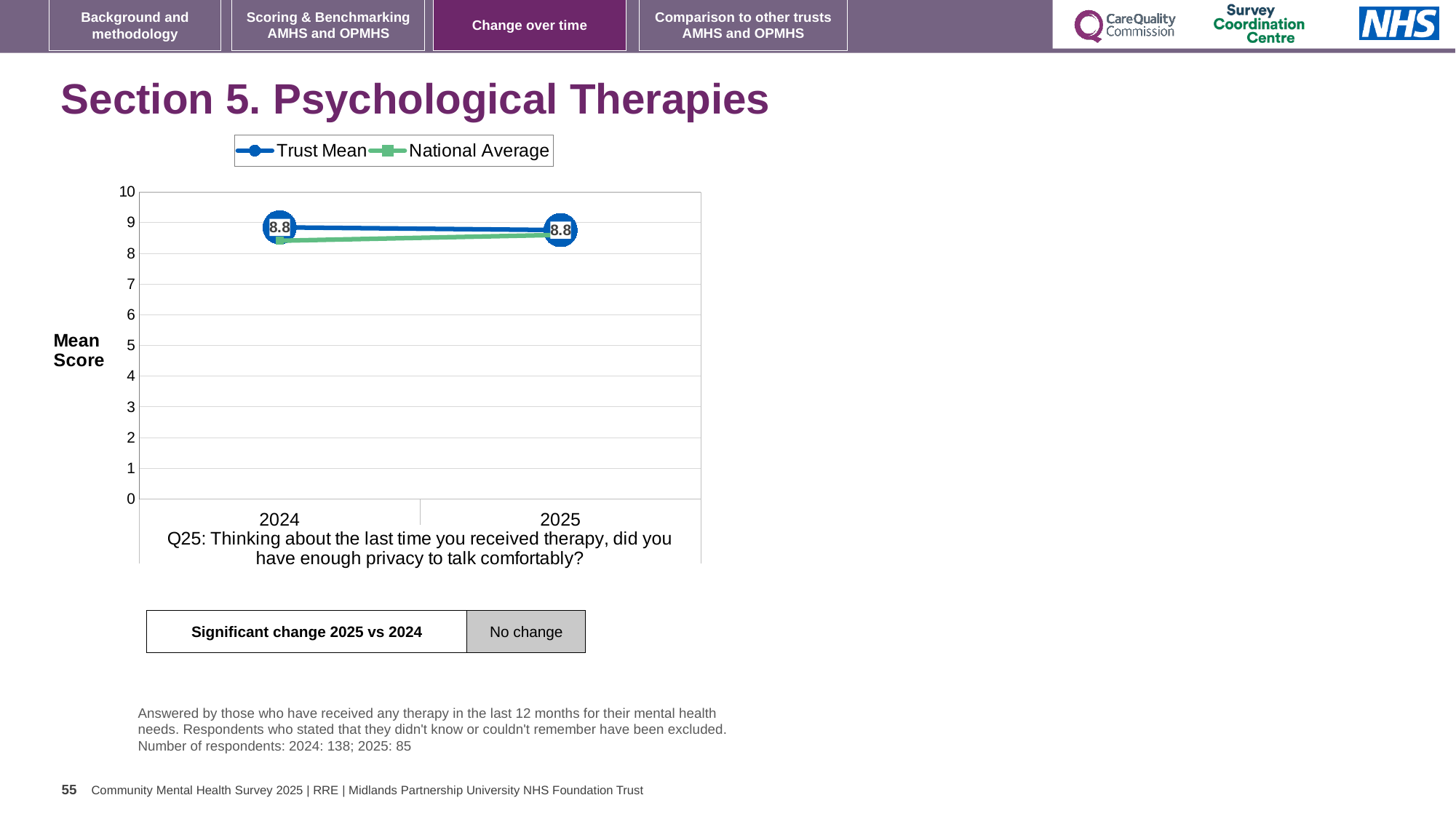
Is the National Average value for 2024 greater or less than 8? greater What is the label on the y axis of the chart? Mean Score What is the Trust Mean value for 2025? 8.8 How many series does the legend list? 2 Does the National Average rise or fall from 2024 to 2025? rises Is the National Average value for 2024 greater or less than 9? less What is the difference between the Trust Mean in 2025 and the Trust Mean in 2024? 0 What kind of chart is shown on the slide? line chart How many years are plotted on the x axis? 2 Does the Trust Mean rise, fall or stay the same from 2024 to 2025? stays the same What is the Trust Mean value for 2024? 8.8 In 2024, which is higher: the Trust Mean or the National Average? Trust Mean